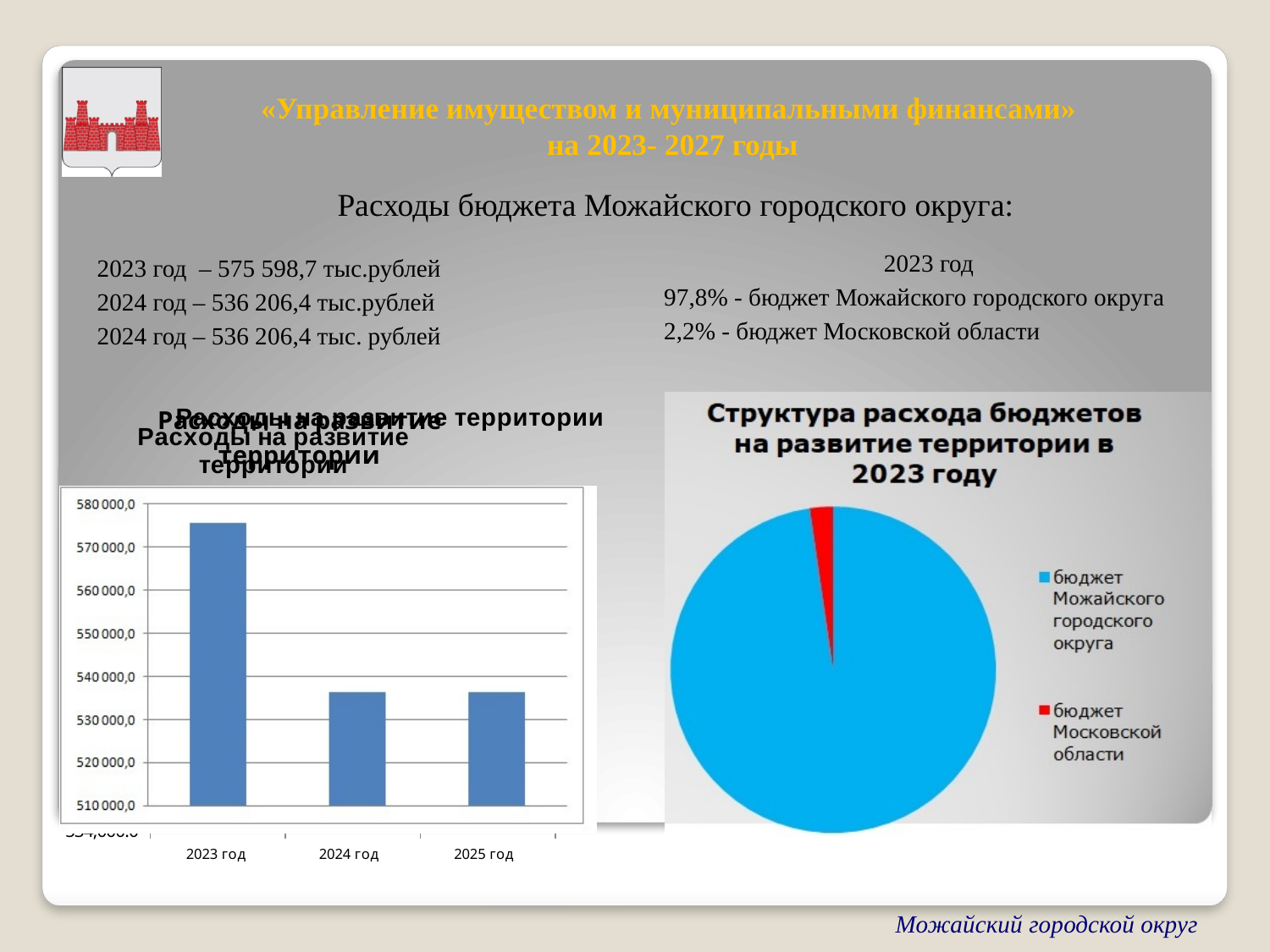
In the pie chart «Структура расхода бюджетов на развитие территории в 2023 году», which slice is the largest? бюджет Можайского городского округа In the bar chart «Расходы на развитие территории», which year has the highest bar? 2023 год In the bar chart «Расходы на развитие территории», how many years are shown on the x axis? 3 In the bar chart «Расходы на развитие территории», is the value for 2023 год greater or less than 570 000,0? greater In the pie chart «Структура расхода бюджетов на развитие территории в 2023 году», which slice is the smallest? бюджет Московской области In the bar chart «Расходы на развитие территории», is the value for 2024 год greater or less than 540 000,0? less In the bar chart «Расходы на развитие территории», does the value rise or fall from 2023 год to 2024 год? fall What kind of chart is the left chart titled «Расходы на развитие территории»? bar chart In the pie chart «Структура расхода бюджетов на развитие территории в 2023 году», what colour is the slice for бюджет Московской области? red In the bar chart «Расходы на развитие территории», which is larger, the value for 2023 год or for 2024 год? 2023 год How many entries does the legend of the pie chart «Структура расхода бюджетов на развитие территории в 2023 году» list? 2 What kind of chart is the right chart titled «Структура расхода бюджетов на развитие территории в 2023 году»? pie chart